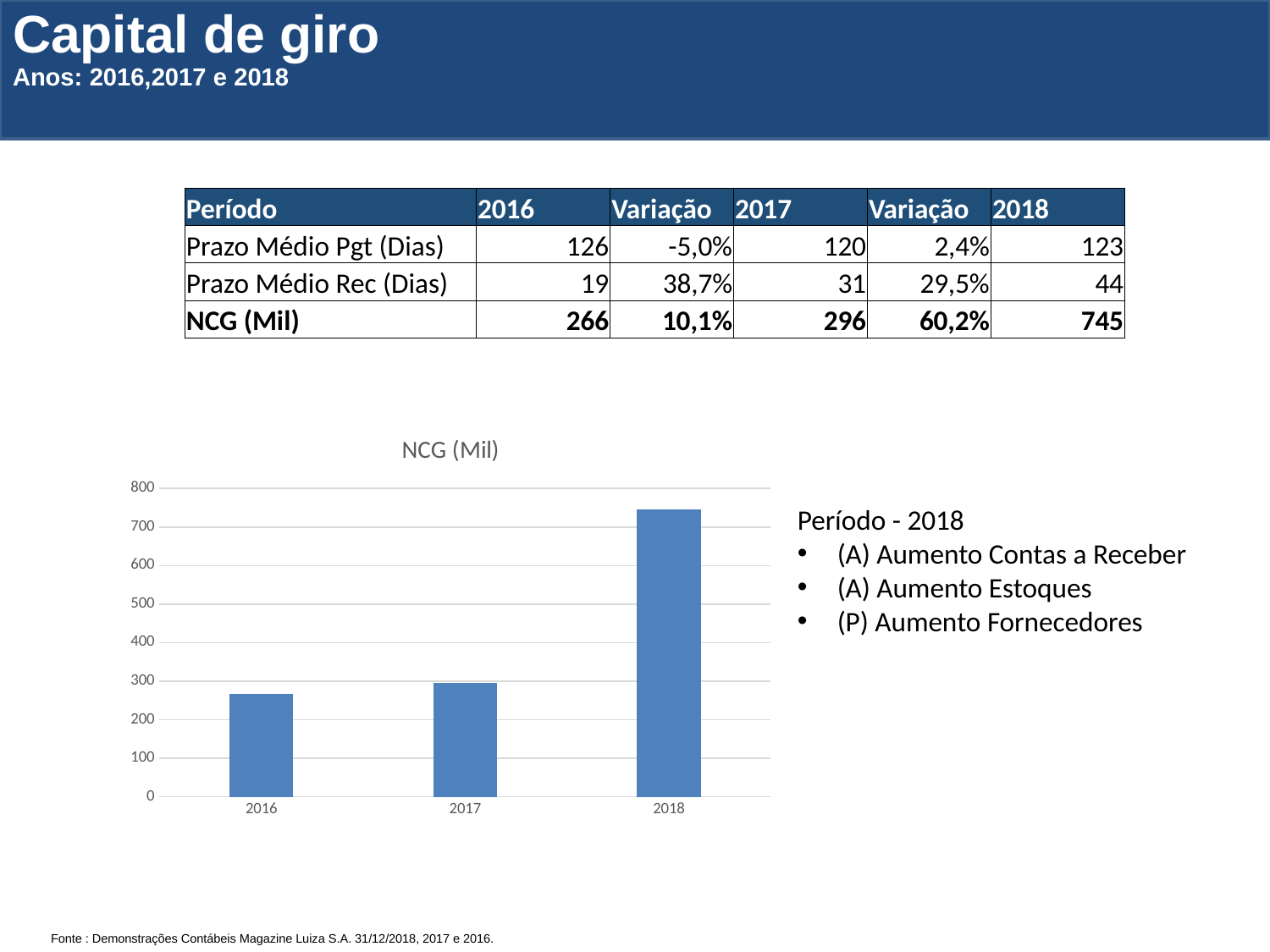
According to the table on the slide, what is the NCG (Mil) value for 2018? 745 Is the NCG (Mil) value for 2018 greater or less than 700? greater What kind of chart is shown on the slide? bar chart Which year has the highest NCG (Mil) value in the chart? 2018 Which is larger in the NCG (Mil) chart, the value for 2017 or the value for 2018? 2018 Using the NCG (Mil) values printed in the table, what is the difference between 2018 and 2017? 449 Do the NCG (Mil) values rise or fall from 2016 to 2018? rise Which year has the lowest NCG (Mil) value in the chart? 2016 How many bars (years) does the NCG (Mil) chart show? 3 Is the NCG (Mil) value for 2017 greater or less than 200? greater Is the NCG (Mil) value for 2016 greater or less than 300? less What is the title of the chart? NCG (Mil)